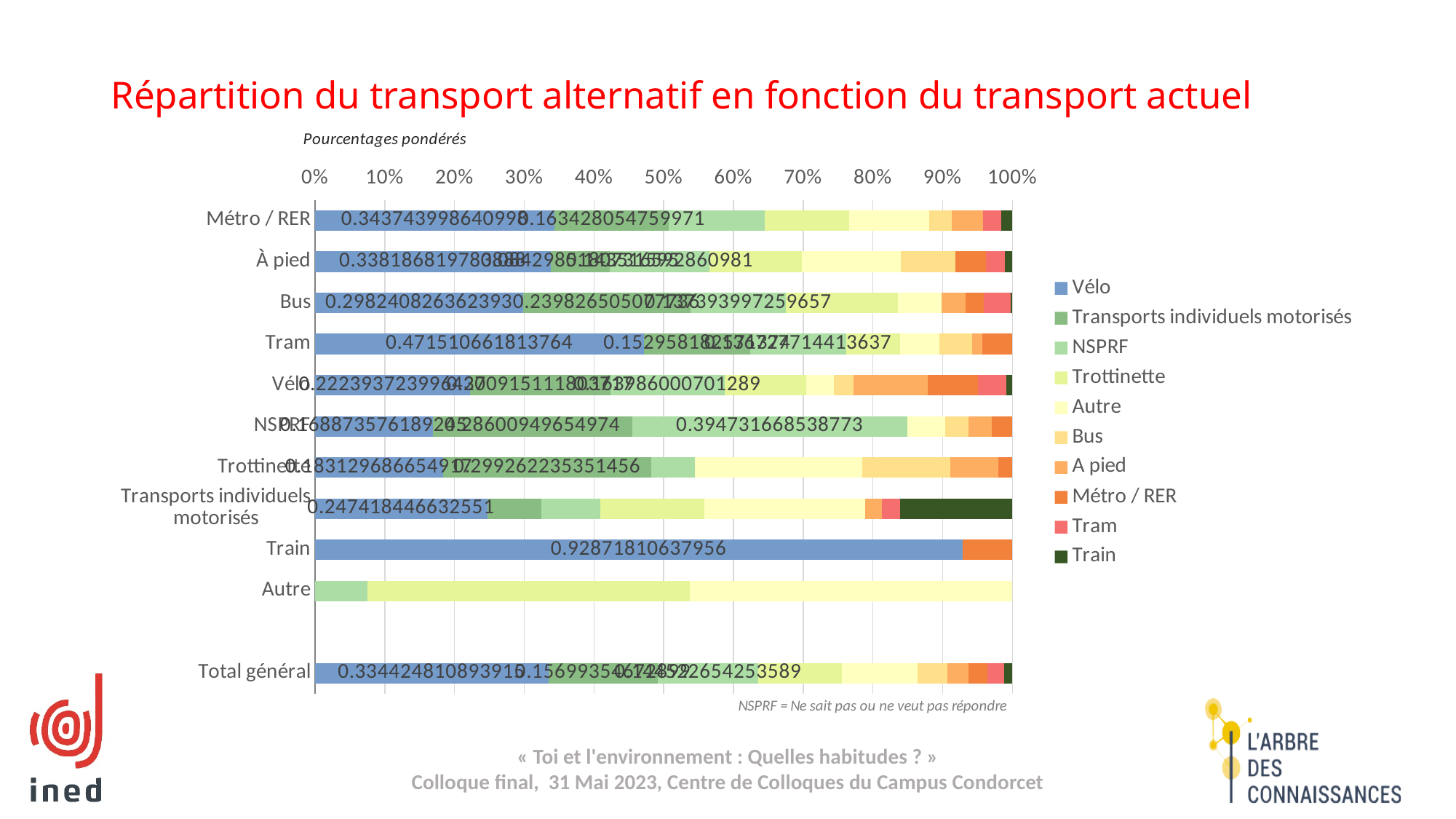
What is the Vélo value for the Transports individuels motorisés row? 0.247418446632551 How many categories (rows) are plotted on the vertical axis, including Total général? 11 What is the Vélo value for the Tram row? 0.471510661813764 Which row has the larger Vélo share, Tram or Métro / RER? Tram How many series does the legend list? 10 Is the Vélo share for the Train row greater or less than 90%? greater What kind of chart is shown on the slide? Stacked bar chart Which row has the largest Vélo share? Train What is the Vélo value for the Métro / RER row? 0.343743998640998 What is the title of the chart? Répartition du transport alternatif en fonction du transport actuel What is the Vélo value for the Train row? 0.92871810637956 What is the NSPRF value for the NSPRF row? 0.394731668538773